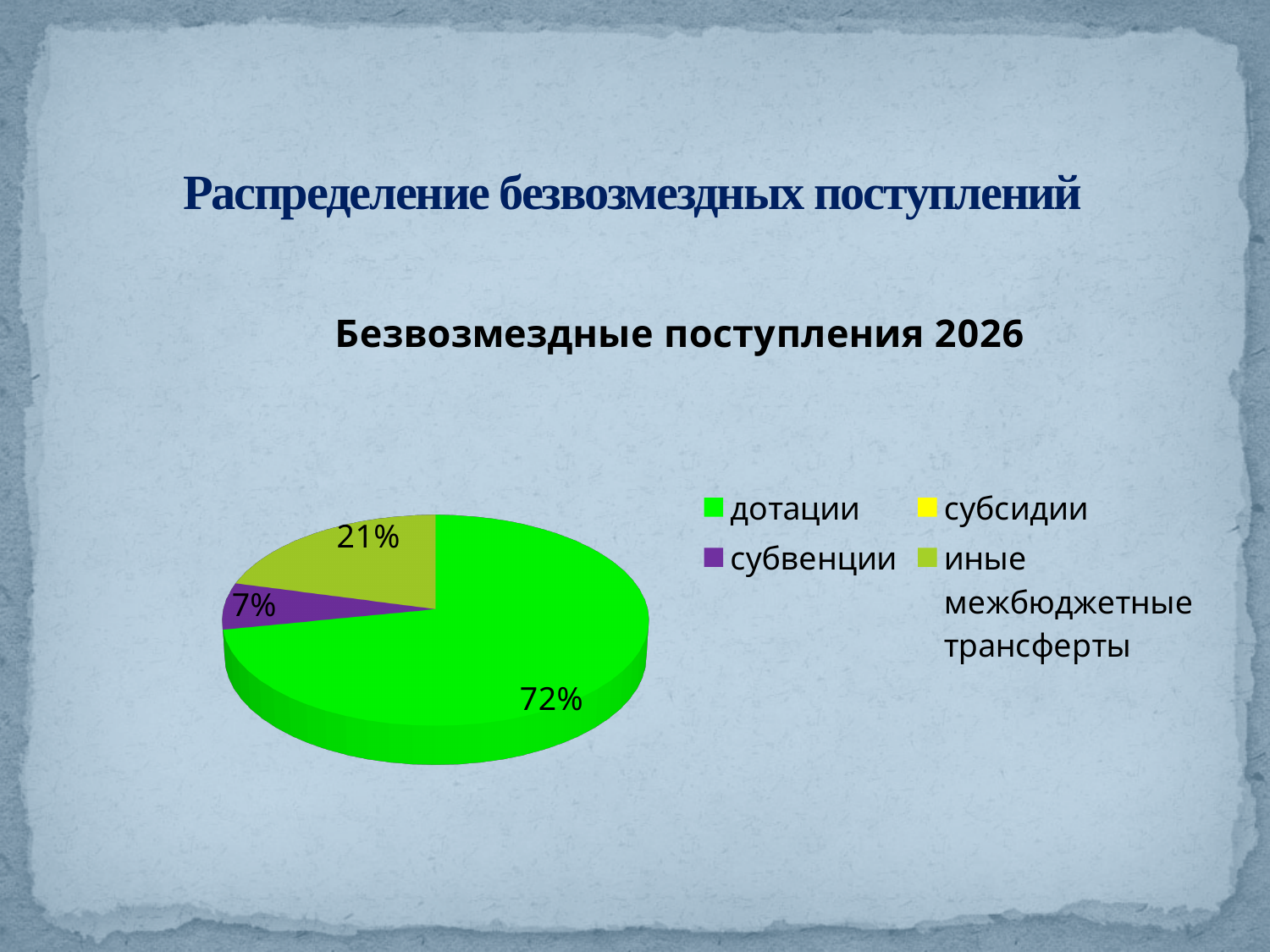
What kind of chart is shown on the slide? pie chart How many entries does the legend list? 4 What is the title of the chart? Безвозмездные поступления 2026 What share of the pie does дотации have? 72% What colour is the slice for дотации? green What share of the pie does субвенции have? 7% Which of the labeled slices is the smallest? субвенции Which is larger, the share of субвенции or the share of иные межбюджетные трансферты? иные межбюджетные трансферты What share of the pie does иные межбюджетные трансферты have? 21% What is the difference between the shares of иные межбюджетные трансферты and субвенции? 14% Which category has the largest slice of the pie? дотации What is the difference between the shares of дотации and иные межбюджетные трансферты? 51%